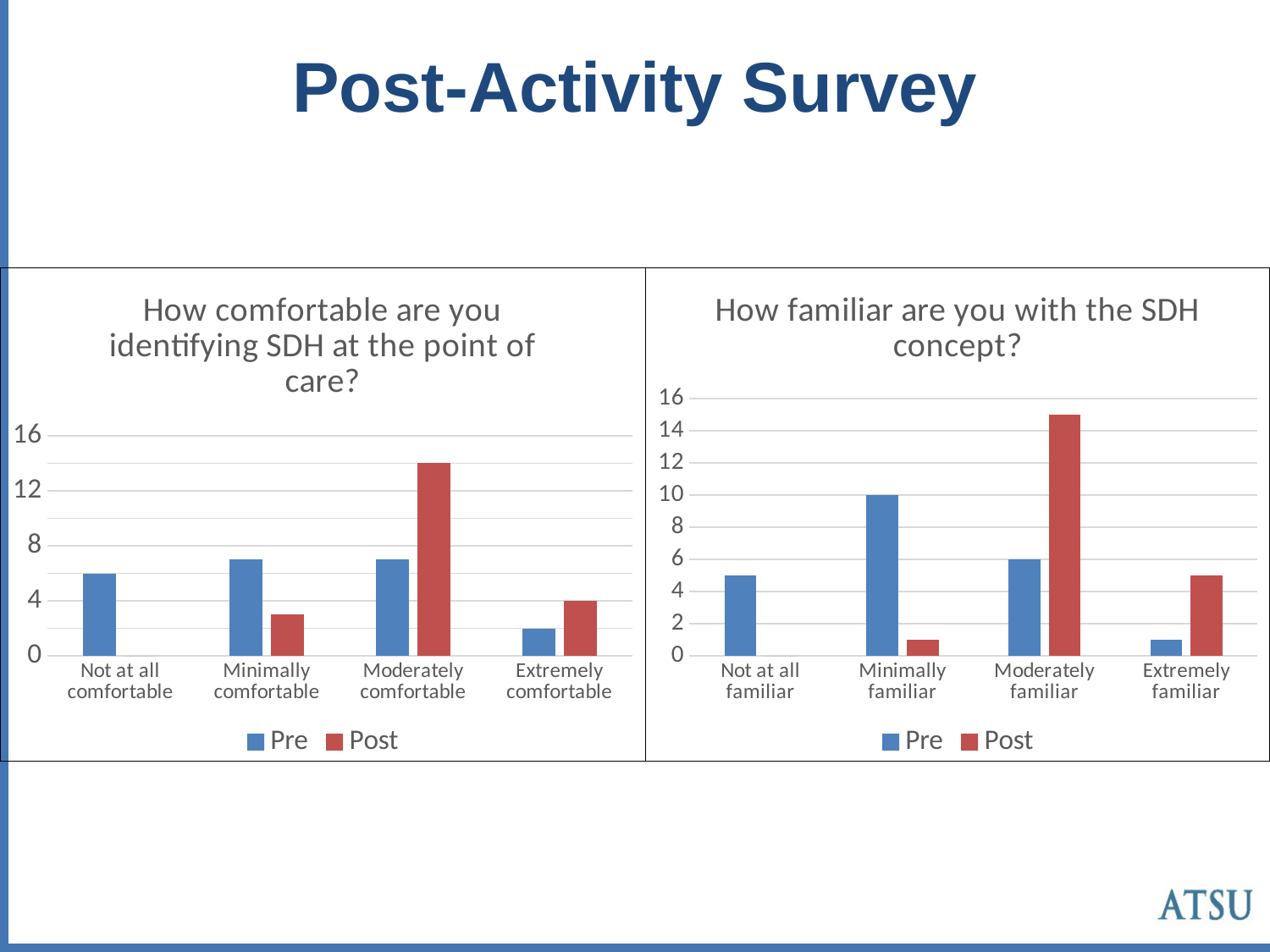
How many categories are shown on the x axis of the left chart, "How comfortable are you identifying SDH at the point of care?"? 4 In the left chart, "How comfortable are you identifying SDH at the point of care?", which is larger for Minimally comfortable, the Pre value or the Post value? Pre In the right chart, "How familiar are you with the SDH concept?", which category has the lowest Pre value? Extremely familiar How many series does the legend list in the right chart, "How familiar are you with the SDH concept?"? 2 In the left chart, "How comfortable are you identifying SDH at the point of care?", is the Pre value for Extremely comfortable greater or less than 4? less What type of chart is the left chart, "How comfortable are you identifying SDH at the point of care?"? bar chart In the right chart, "How familiar are you with the SDH concept?", which category has the highest Post value? Moderately familiar In the right chart, "How familiar are you with the SDH concept?", what is the Pre value for Minimally familiar? 10 In the right chart, "How familiar are you with the SDH concept?", is the Post value for Moderately familiar greater or less than 14? greater In the right chart, "How familiar are you with the SDH concept?", what is the Pre value for Moderately familiar? 6 In the left chart, "How comfortable are you identifying SDH at the point of care?", which category has the highest Post value? Moderately comfortable In the left chart, "How comfortable are you identifying SDH at the point of care?", is the Post value for Moderately comfortable greater or less than 12? greater